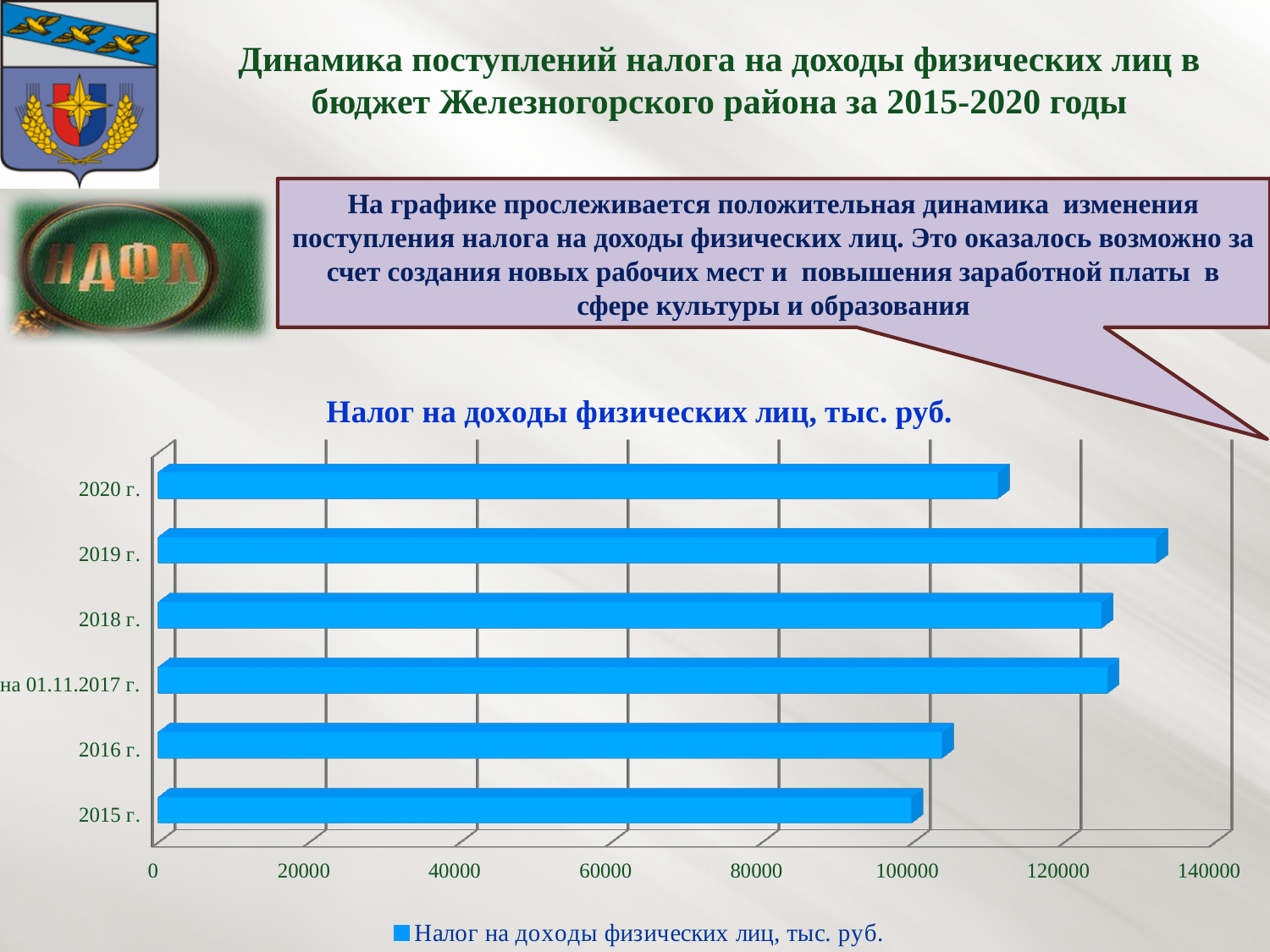
Is the value for 2019 г. greater or less than 120000? greater Is the value for 2020 г. greater or less than 120000? less Is the value for 2016 г. greater or less than 120000? less Which is larger, the value for 2016 г. or the value for 2018 г.? 2018 г. How many series does the legend list? 1 How many categories (years) are plotted in the chart? 6 Which year has the lowest value in the chart? 2015 г. Which year has the highest value in the chart? 2019 г. What kind of chart is shown on the slide? bar chart Which is larger, the value for 2019 г. or the value for 2020 г.? 2019 г. What is the title of the chart? Налог на доходы физических лиц, тыс. руб.